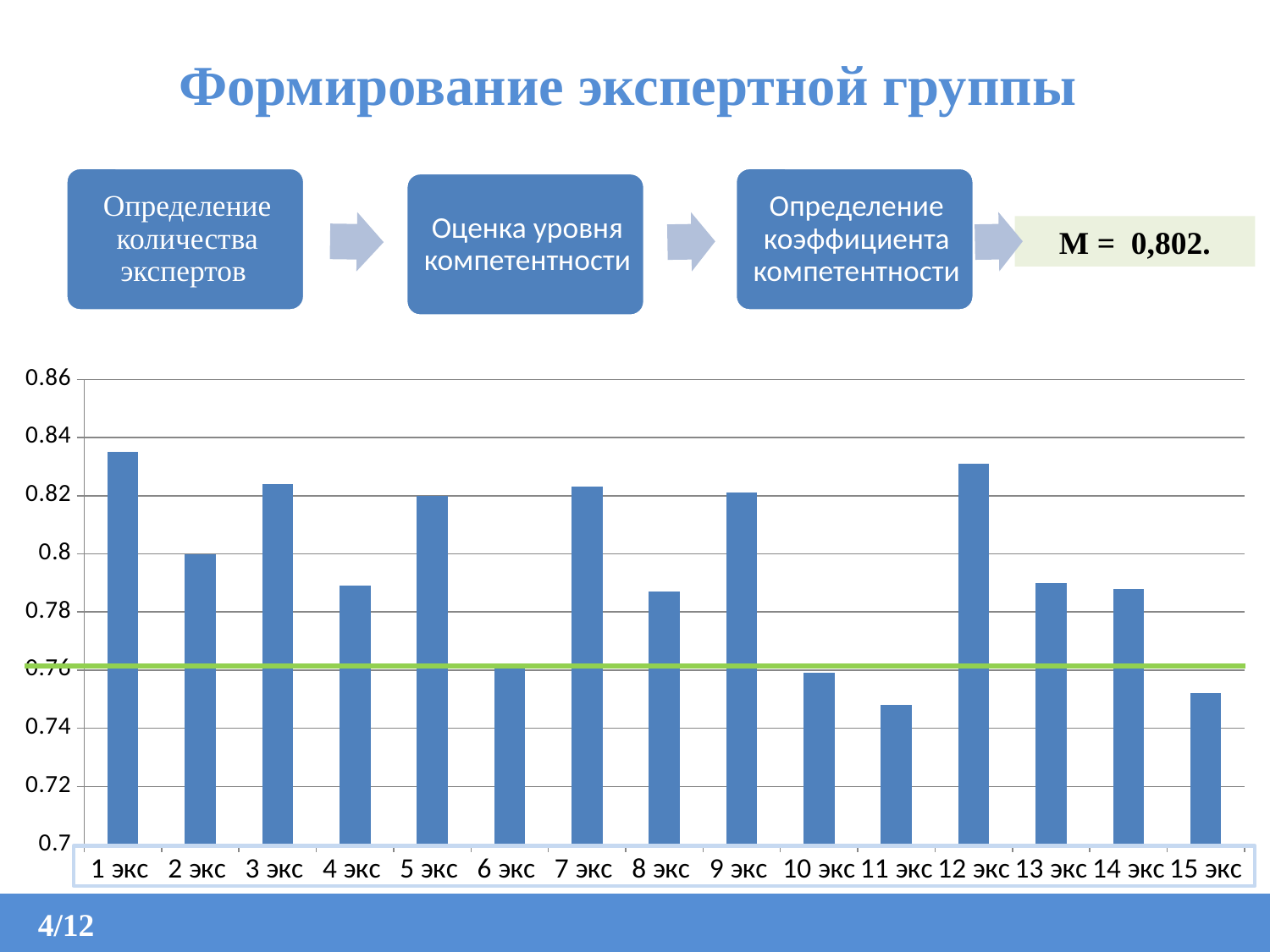
Which is larger, the value for 3 экс or the value for 8 экс? 3 экс Is the value for 4 экс greater or less than 0.8? less Is the value for 1 экс greater or less than 0.82? greater What kind of chart is shown on the slide? bar chart Which category has the highest bar in the chart? 1 экс What is the highest value shown on the chart's vertical axis? 0.86 Which category has the lowest bar in the chart? 11 экс Is the value for 6 экс greater or less than 0.78? less Which is larger, the value for 9 экс or the value for 10 экс? 9 экс How many categories (experts) are shown on the x axis of the chart? 15